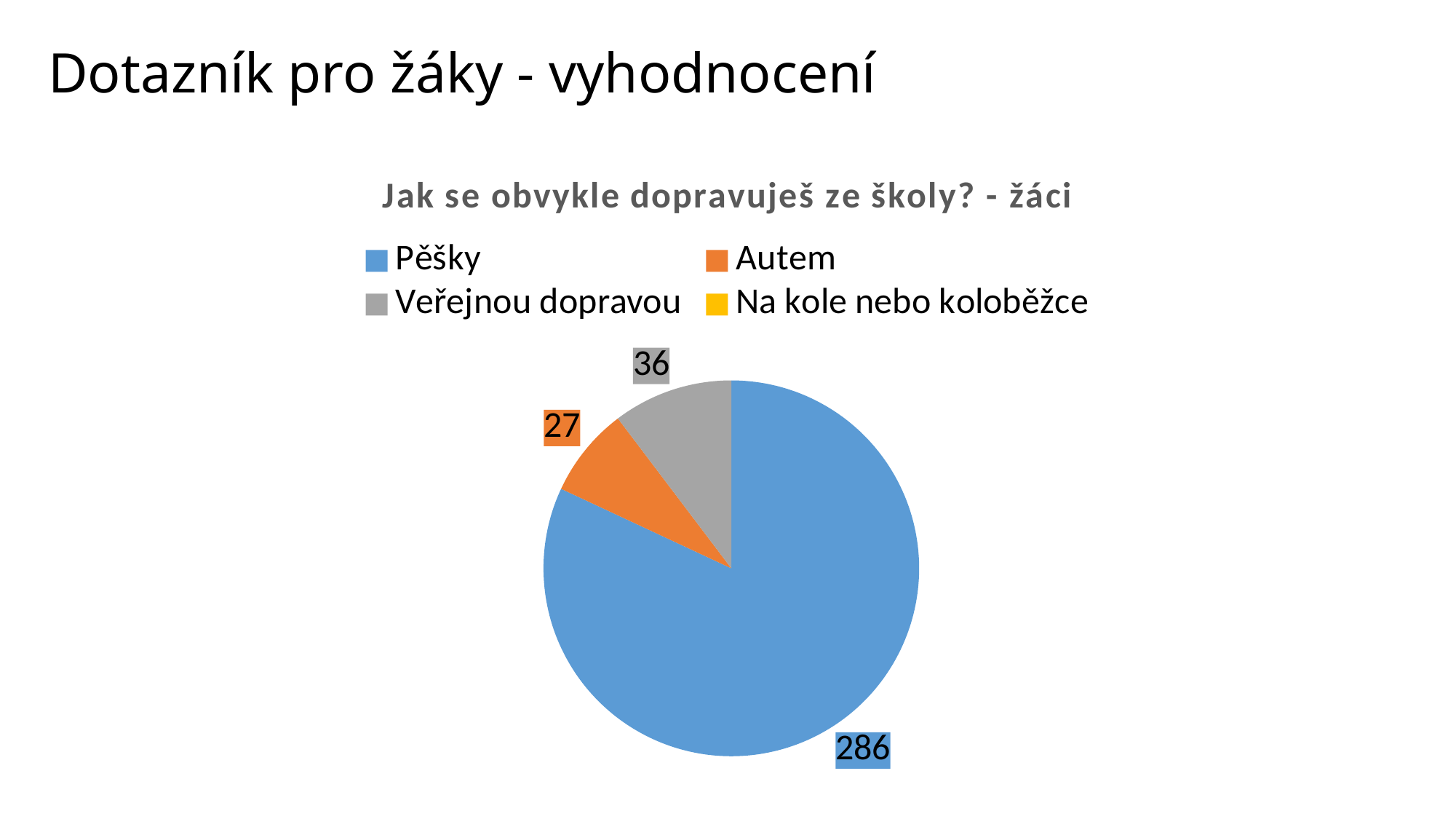
Which category has the largest slice of the pie? Pěšky What is the value for Autem? 27 What is the value for Pěšky? 286 What is the difference between the values for Veřejnou dopravou and Autem? 9 Which of the labelled slices has the smallest value? Autem What is the difference between the values for Pěšky and Veřejnou dopravou? 250 What is the title of the pie chart? Jak se obvykle dopravuješ ze školy? - žáci What colour is the slice for Pěšky? blue Which is larger, the value for Autem or the value for Veřejnou dopravou? Veřejnou dopravou What kind of chart is shown on the slide? pie chart What is the value for Veřejnou dopravou? 36 How many categories does the legend list? 4